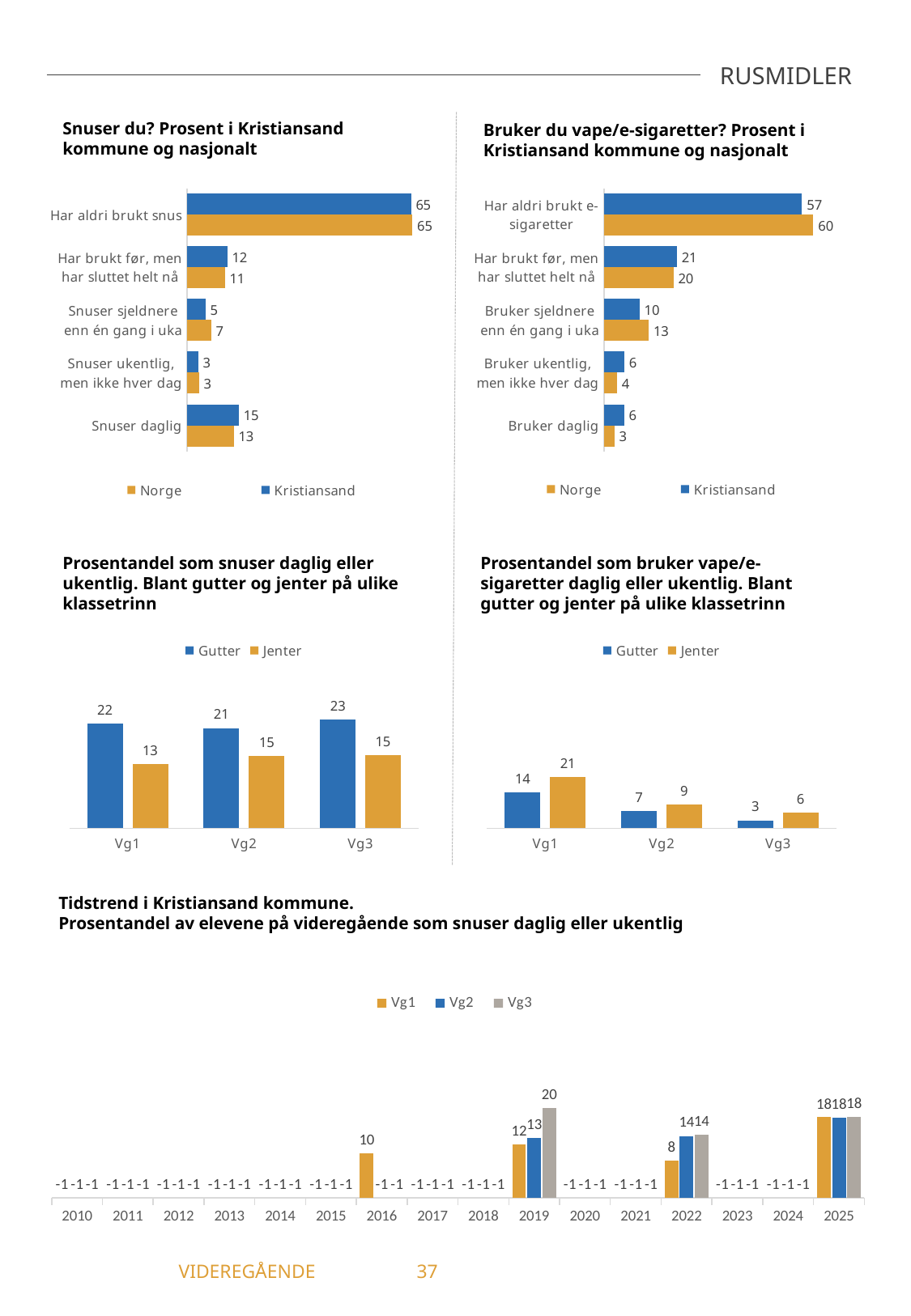
In the chart 'Bruker du vape/e-sigaretter? Prosent i Kristiansand kommune og nasjonalt', which is larger for 'Bruker daglig': Kristiansand or Norge? Kristiansand In the chart 'Prosentandel som bruker vape/e-sigaretter daglig eller ukentlig. Blant gutter og jenter på ulike klassetrinn', do the Gutter values rise or fall from Vg1 to Vg3? fall What kind of chart is 'Tidstrend i Kristiansand kommune'? bar chart In the chart 'Tidstrend i Kristiansand kommune', how many series does the legend list? 3 In the chart 'Bruker du vape/e-sigaretter? Prosent i Kristiansand kommune og nasjonalt', what is the Norge value for 'Har aldri brukt e-sigaretter'? 60 In the chart 'Prosentandel som snuser daglig eller ukentlig. Blant gutter og jenter på ulike klassetrinn', what is the value for Jenter at Vg1? 13 In the chart 'Snuser du? Prosent i Kristiansand kommune og nasjonalt', what is the value for Kristiansand for 'Snuser daglig'? 15 In the chart 'Bruker du vape/e-sigaretter? Prosent i Kristiansand kommune og nasjonalt', how many series does the legend list? 2 In the chart 'Snuser du? Prosent i Kristiansand kommune og nasjonalt', what is the difference between the Kristiansand and Norge values for 'Har brukt før, men har sluttet helt nå'? 1 In the chart 'Tidstrend i Kristiansand kommune', what is the value for Vg3 in 2019? 20 In the chart 'Prosentandel som snuser daglig eller ukentlig. Blant gutter og jenter på ulike klassetrinn', which class level has the highest value for Gutter? Vg3 In the chart 'Prosentandel som bruker vape/e-sigaretter daglig eller ukentlig. Blant gutter og jenter på ulike klassetrinn', what is the difference between Jenter and Gutter at Vg1? 7